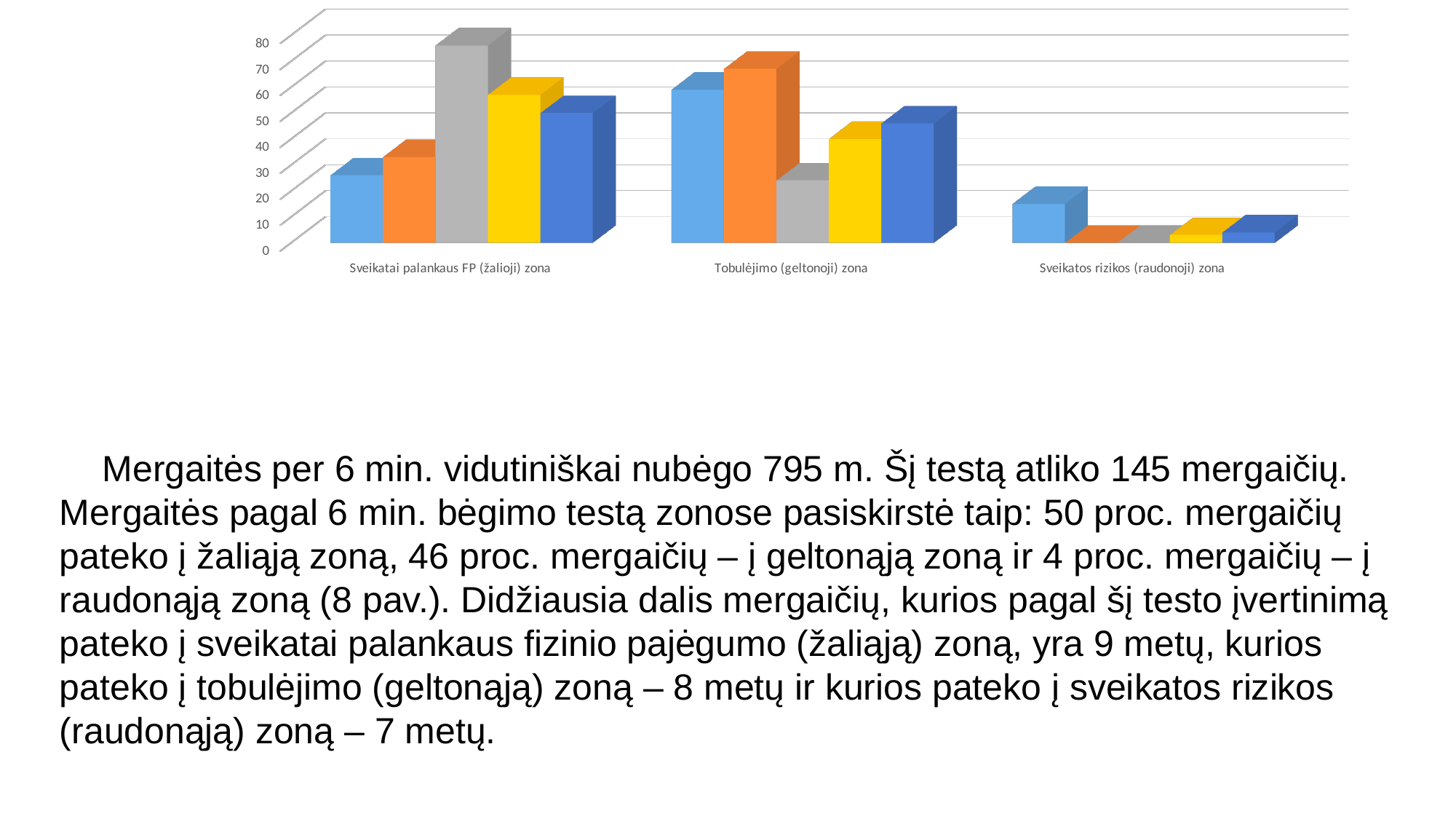
Which category contains the tallest bar in the chart? Sveikatai palankaus FP (žalioji) zona What is the label of the first category on the x axis? Sveikatai palankaus FP (žalioji) zona How many categories are shown on the x axis of the chart? 3 Is the tallest bar in the Sveikatos rizikos (raudonoji) zona category greater or less than 20? less How many bars are plotted in each category of the chart? 5 Is the tallest bar in the Sveikatai palankaus FP (žalioji) zona category greater or less than 60? greater Is the tallest bar in the Tobulėjimo (geltonoji) zona category greater or less than 50? greater What kind of chart is shown on the slide? bar chart What is the highest value shown on the vertical axis of the chart? 80 Which category has the lowest bars overall? Sveikatos rizikos (raudonoji) zona What is the label of the last category on the x axis? Sveikatos rizikos (raudonoji) zona